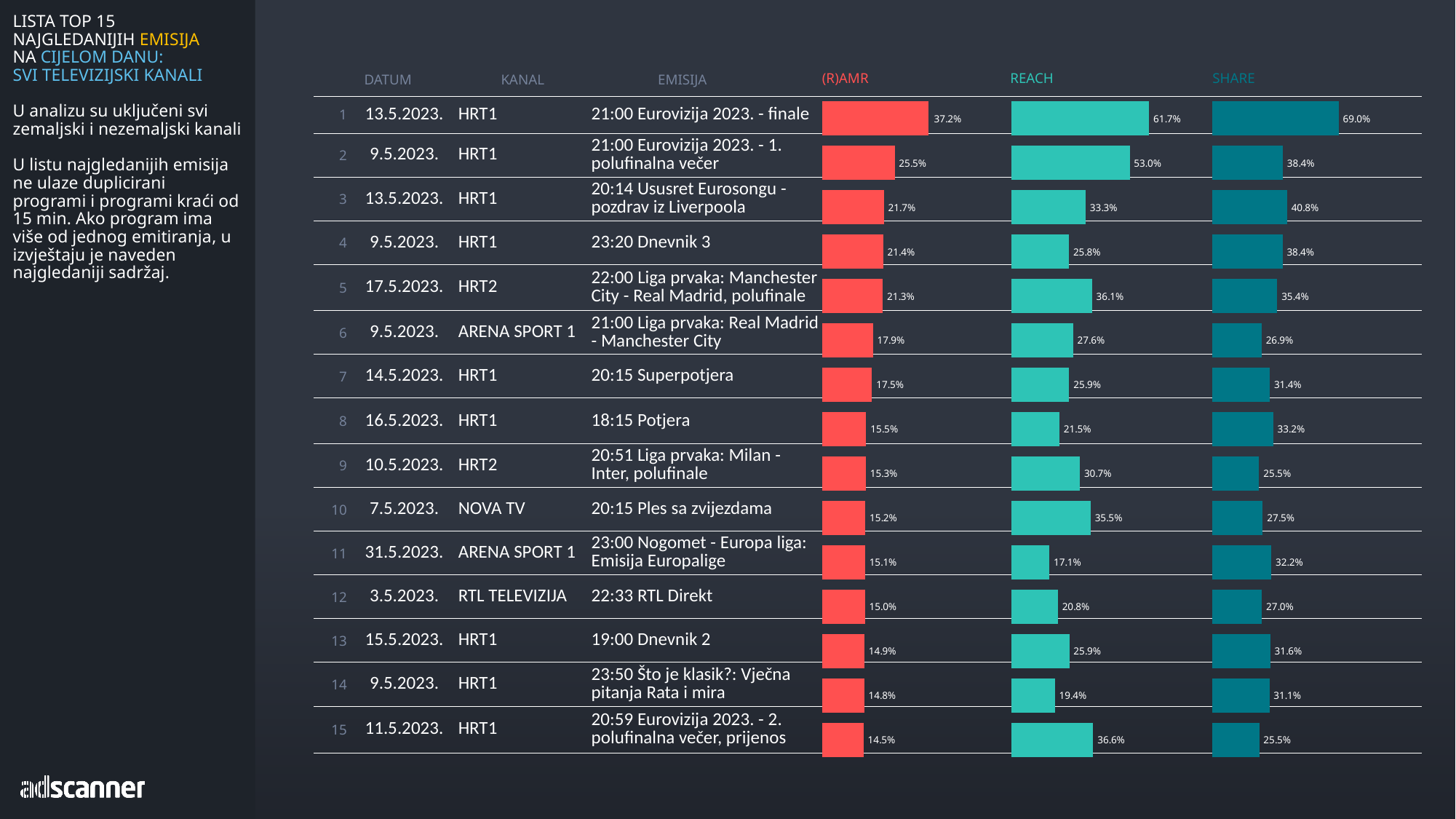
In the SHARE chart, what is the value for 20:14 Ususret Eurosongu - pozdrav iz Liverpoola? 40.8% In the SHARE chart, what is the difference between 21:00 Eurovizija 2023. - finale and 21:00 Eurovizija 2023. - 1. polufinalna večer? 30.6% In the (R)AMR chart, what is the value for 21:00 Eurovizija 2023. - finale? 37.2% In the REACH chart, which is larger: 22:00 Liga prvaka: Manchester City - Real Madrid, polufinale or 20:51 Liga prvaka: Milan - Inter, polufinale? 22:00 Liga prvaka: Manchester City - Real Madrid, polufinale Do the (R)AMR values rise or fall going down the list from rank 1 to rank 15? fall In the REACH chart, which programme has the highest value? 21:00 Eurovizija 2023. - finale How many programmes are listed in the (R)AMR chart? 15 In the REACH chart, which programme has the lowest value? 23:00 Nogomet - Europa liga: Emisija Europalige In the REACH chart, what is the value for 20:15 Ples sa zvijezdama? 35.5% What kind of chart is used for the (R)AMR, REACH and SHARE columns? bar chart In the (R)AMR chart, which programme has the lowest value? 20:59 Eurovizija 2023. - 2. polufinalna večer, prijenos What colour are the bars in the (R)AMR chart? red